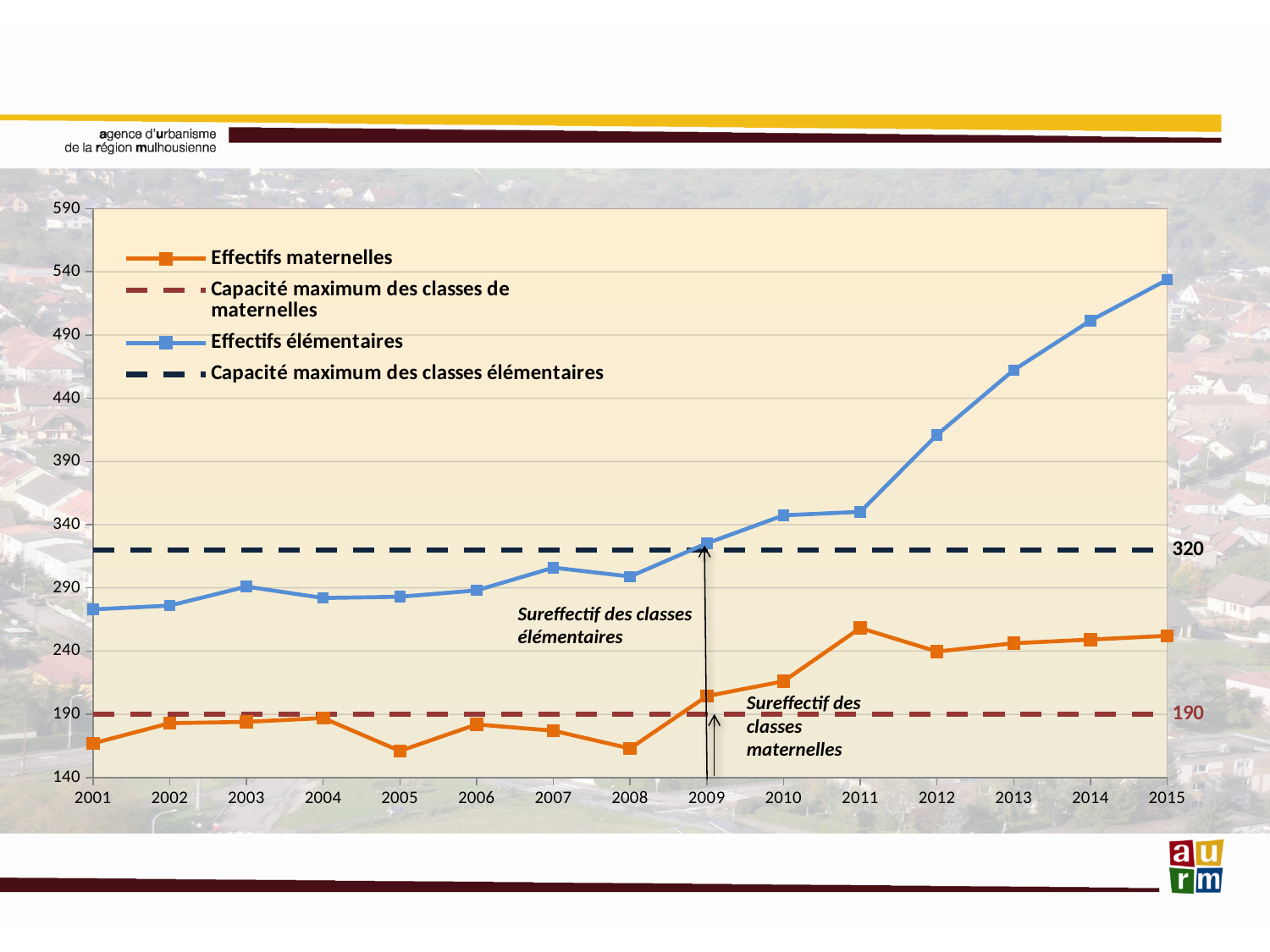
Do the 'Effectifs élémentaires' values rise or fall from 2009 to 2015? rise Which series has the larger value in 2015, 'Effectifs élémentaires' or 'Effectifs maternelles'? Effectifs élémentaires Is the value of 'Effectifs maternelles' in 2011 greater or less than 240? greater Is the value of 'Effectifs maternelles' in 2005 greater or less than 190? less In which year is 'Effectifs élémentaires' highest? 2015 What kind of chart is shown on the slide? line chart How many years are plotted along the x axis? 15 Is the value of 'Effectifs élémentaires' in 2015 greater or less than 490? greater How many series does the legend list? 4 What value is printed for the 'Capacité maximum des classes élémentaires' line? 320 What value is printed for the 'Capacité maximum des classes de maternelles' line? 190